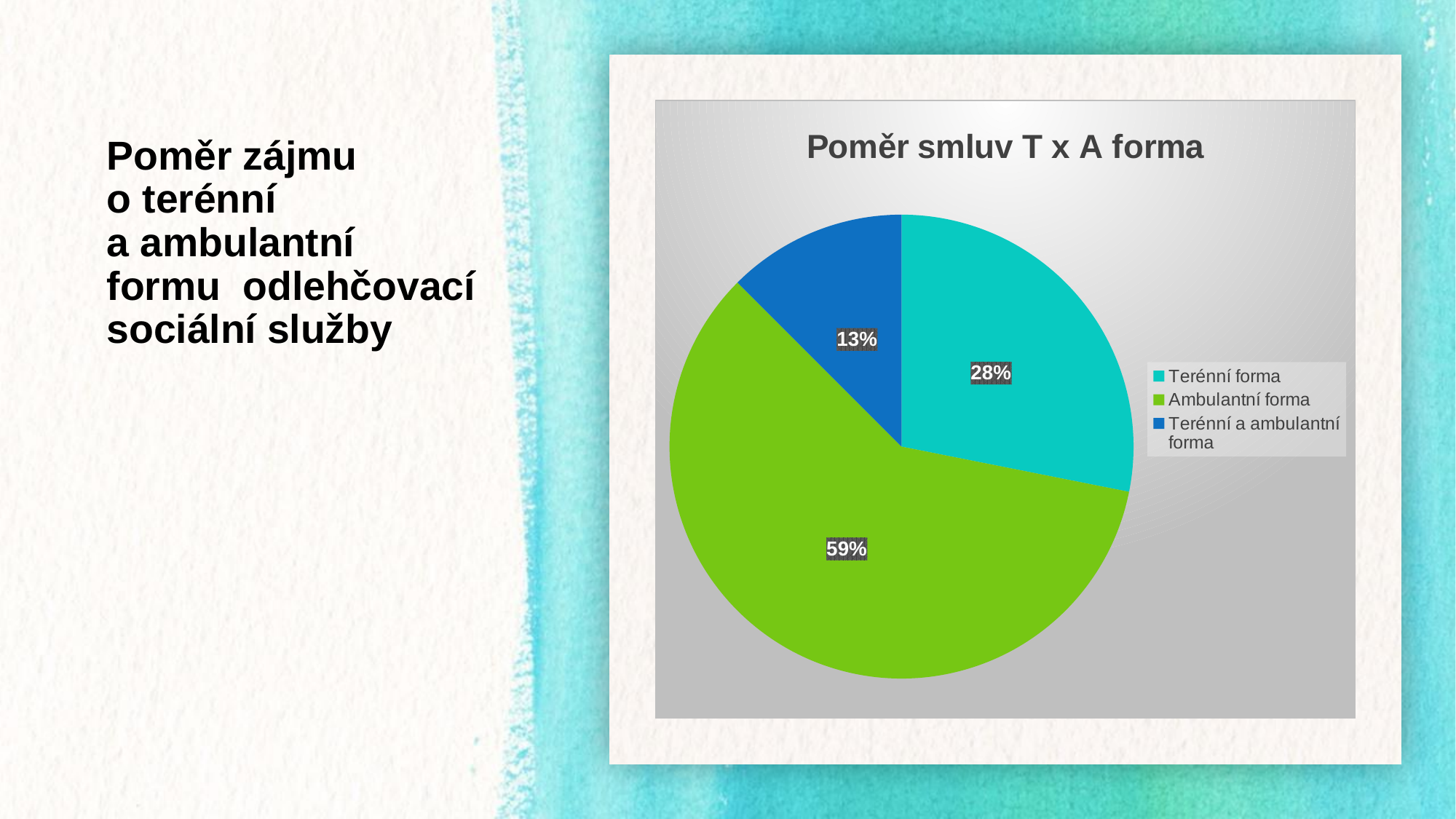
Which category has the smallest slice of the pie? Terénní a ambulantní forma What share of the pie does Terénní a ambulantní forma have? 13% What share of the pie does Terénní forma have? 28% How many slices does the pie chart have? 3 What kind of chart is shown on the slide? pie chart What is the difference in percentage points between Terénní forma and Terénní a ambulantní forma? 15 What share of the pie does Ambulantní forma have? 59% What is the title of the chart? Poměr smluv T x A forma Which is larger, the slice for Terénní forma or the slice for Terénní a ambulantní forma? Terénní forma Which category has the largest slice of the pie? Ambulantní forma What is the difference in percentage points between Ambulantní forma and Terénní forma? 31 What colour is the slice for Ambulantní forma? green